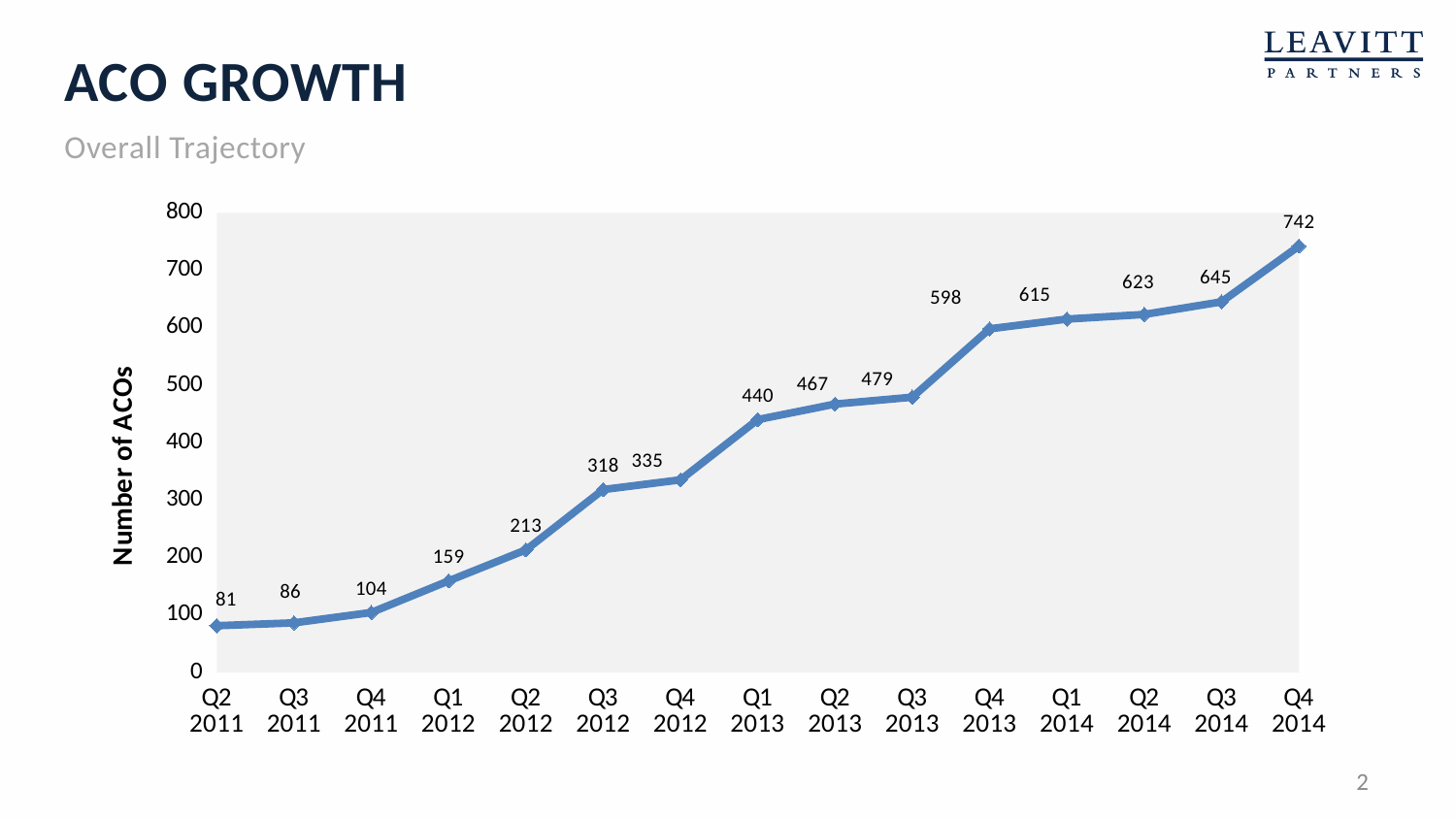
Which quarter has the lowest number of ACOs? Q2 2011 Which has more ACOs, Q3 2012 or Q4 2012? Q4 2012 What is the label on the vertical axis of the chart? Number of ACOs What is the number of ACOs in Q2 2011? 81 What is the number of ACOs in Q2 2012? 213 Do the values rise or fall from Q2 2011 to Q4 2014? Rise What kind of chart is shown on the slide? Line chart What is the number of ACOs in Q4 2014? 742 What is the number of ACOs in Q1 2013? 440 How many quarters are plotted on the chart? 15 Which quarter has the highest number of ACOs? Q4 2014 What is the difference in the number of ACOs between Q4 2013 and Q3 2013? 119